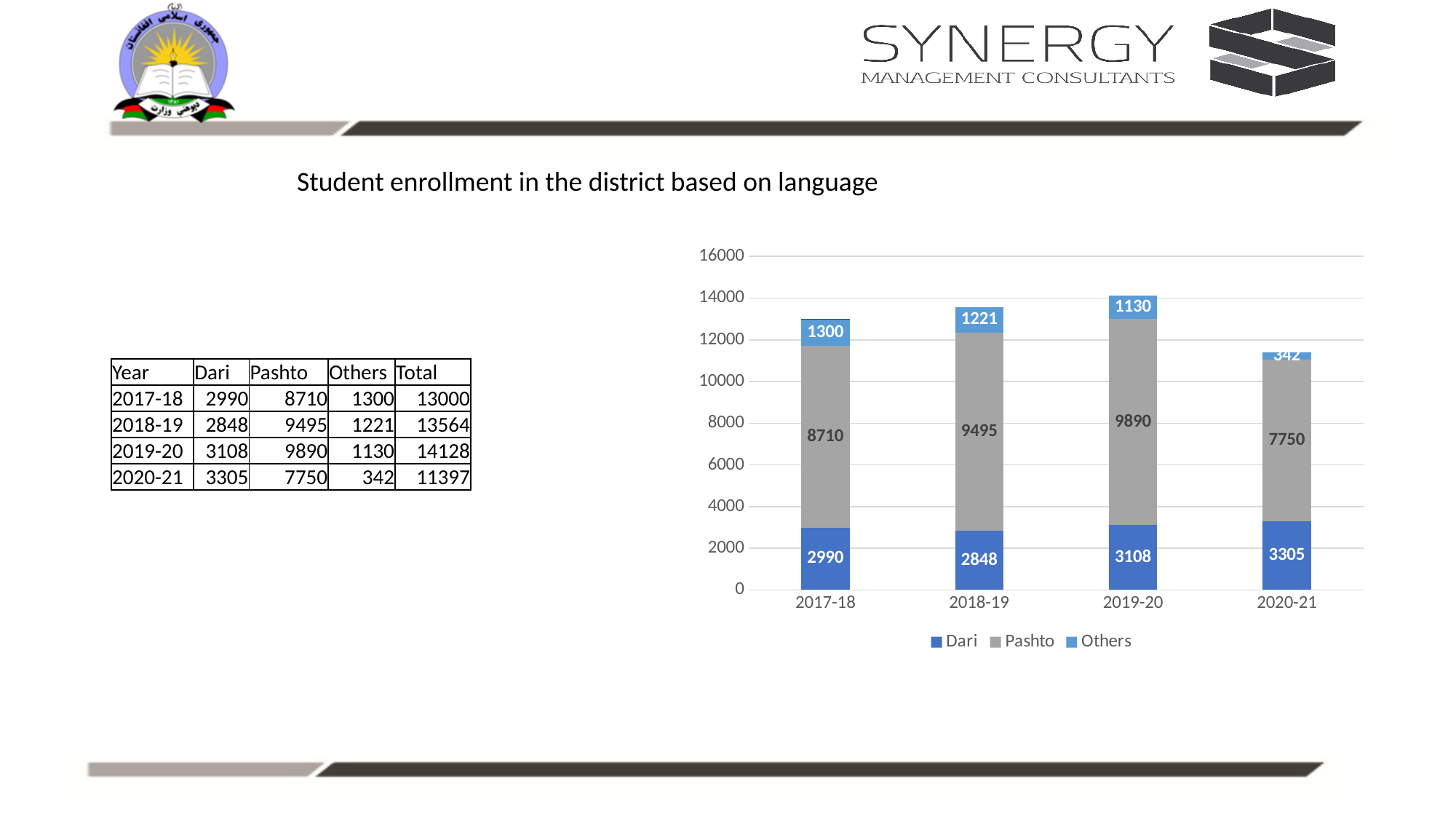
Which year has the highest Pashto enrollment? 2019-20 How many years are shown on the x axis of the chart? 4 What is the Others enrollment value for 2020-21? 342 Which year has the lowest Others enrollment? 2020-21 What kind of chart is shown on the slide? stacked bar chart What is the difference between the Pashto values for 2019-20 and 2020-21? 2140 How many series does the chart legend list? 3 What is the total of the stacked bar for 2018-19? 13564 Is the total stacked bar for 2020-21 greater or less than 12000? less Which is larger, the Dari value for 2017-18 or the Dari value for 2018-19? 2017-18 What is the Pashto enrollment value for 2018-19? 9495 What is the Dari enrollment value for 2019-20? 3108